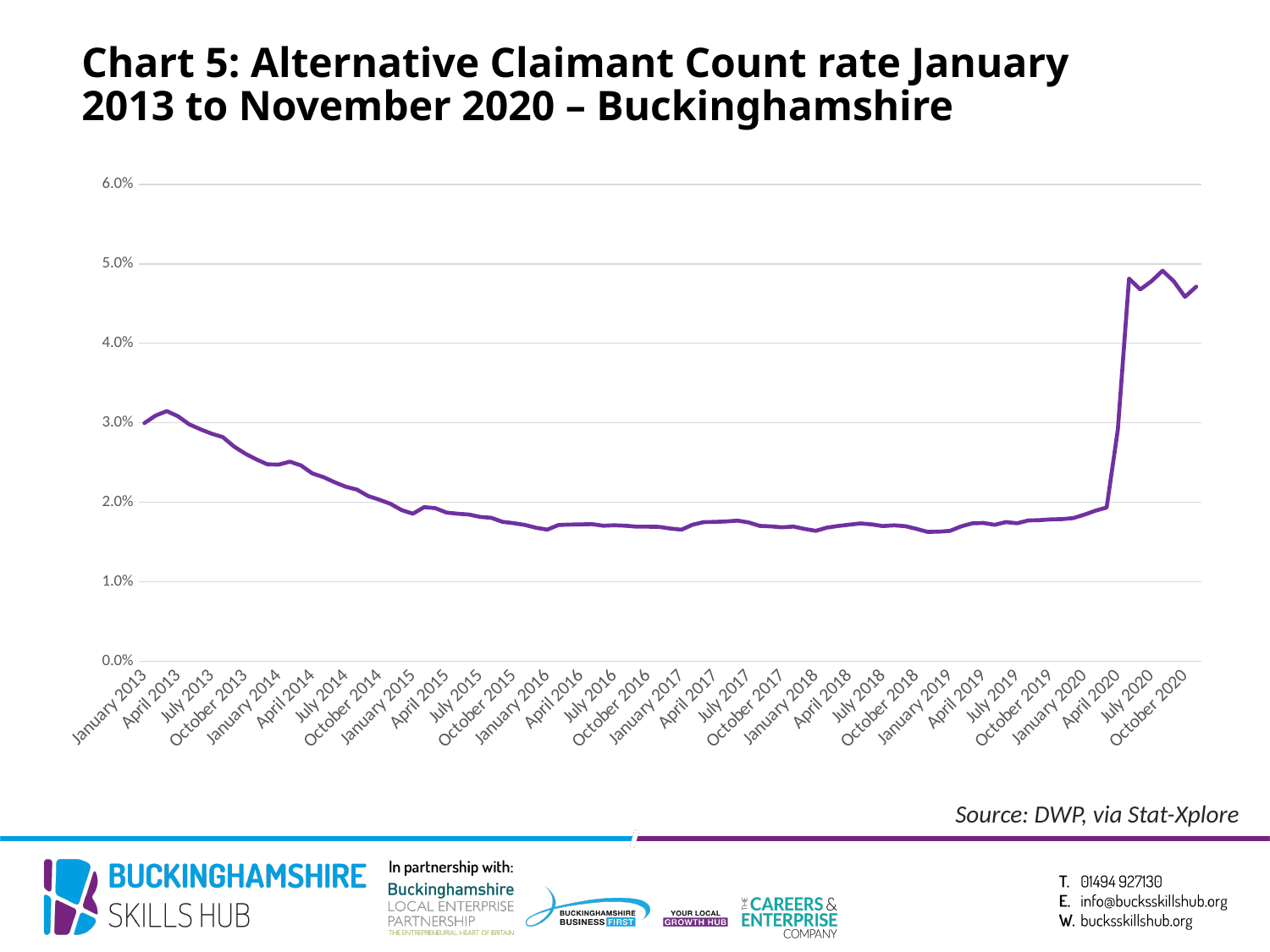
What is the title of the chart? Chart 5: Alternative Claimant Count rate January 2013 to November 2020 – Buckinghamshire Is the value for January 2016 greater or less than 2.0%? less Which is larger, the value for January 2020 or the value for October 2020? October 2020 Which is larger, the value for January 2013 or the value for January 2016? January 2013 Is the value for October 2020 greater or less than 4.0%? greater Is the value for January 2014 greater or less than 2.0%? greater What kind of chart is shown on the slide? line chart What source is cited for the chart data? DWP, via Stat-Xplore Does the claimant count rate rise or fall between January 2013 and January 2016? fall